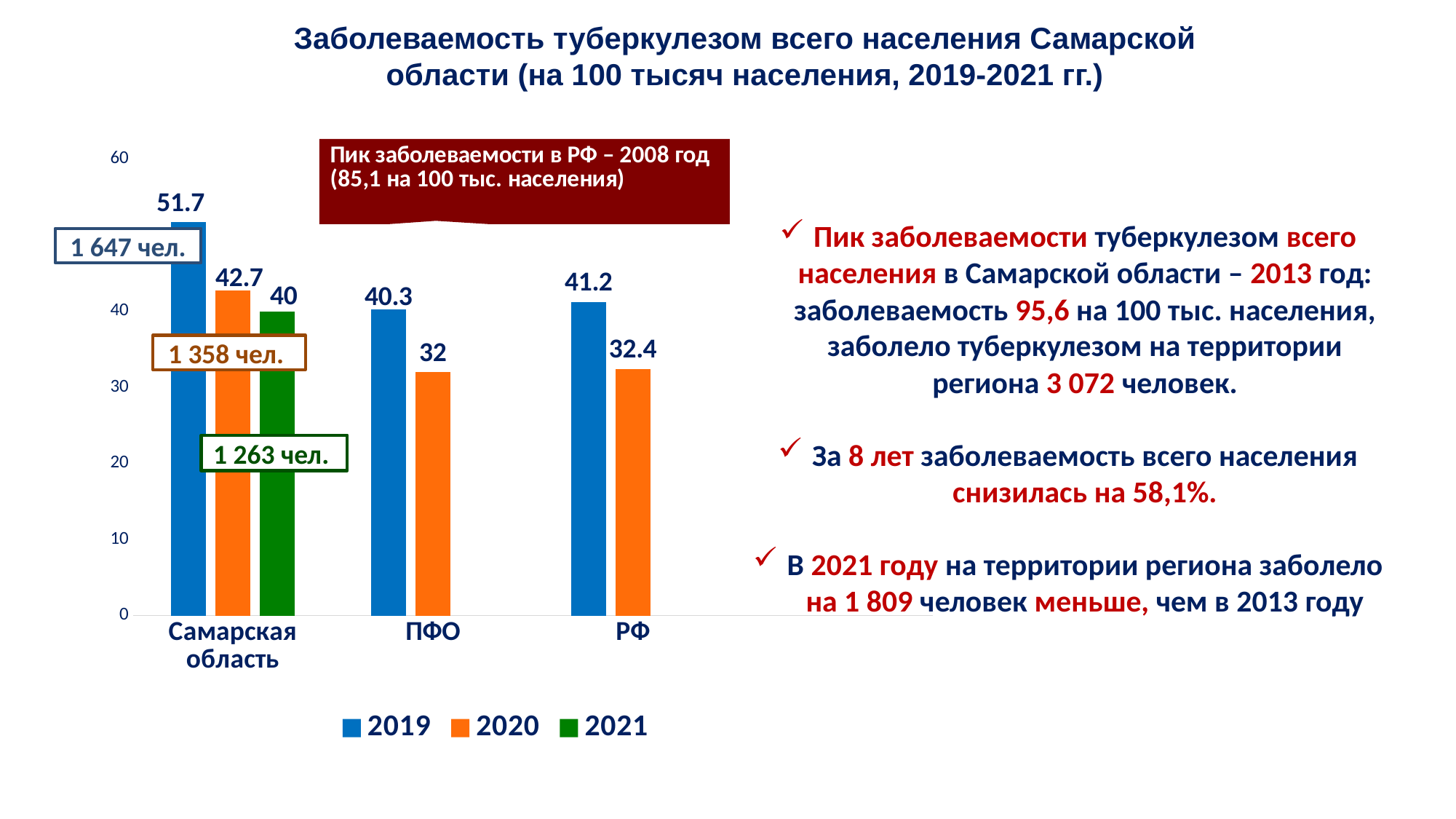
What is the 2020 value for ПФО? 32 How many categories are shown on the x axis? 3 What kind of chart is shown on the slide? bar chart What is the 2019 value for РФ? 41.2 Which is larger: the 2020 value for РФ or the 2020 value for ПФО? РФ Which category has the highest 2019 value? Самарская область How many series does the legend list? 3 What is the difference between the 2019 and 2020 values for Самарская область? 9 What is the 2019 value for Самарская область? 51.7 Which colour represents the 2021 series in the legend? green Which category has the lowest 2020 value? ПФО What is the 2021 value for Самарская область? 40